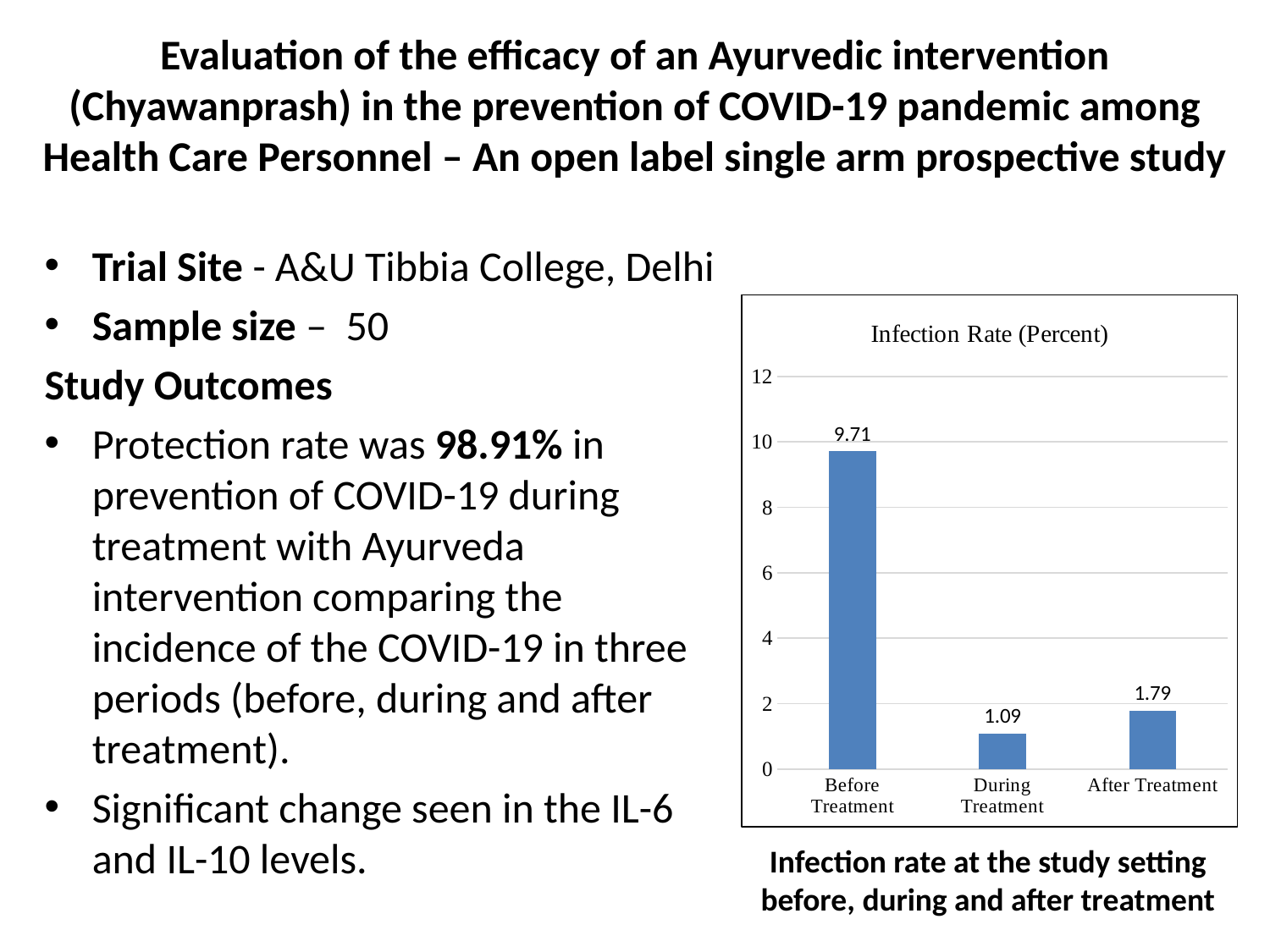
Which period has the lowest infection rate? During Treatment What is the difference between the infection rate after treatment and during treatment? 0.7 Which is larger, the infection rate during treatment or after treatment? After Treatment Which period has the highest infection rate? Before Treatment What kind of chart is shown on the slide? Bar chart What is the title of the chart? Infection Rate (Percent) What is the difference between the infection rate before treatment and during treatment? 8.62 What is the infection rate (percent) after treatment? 1.79 What is the infection rate (percent) before treatment? 9.71 What is the infection rate (percent) during treatment? 1.09 Is the infection rate before treatment greater or less than 8? greater How many periods are shown on the chart? 3